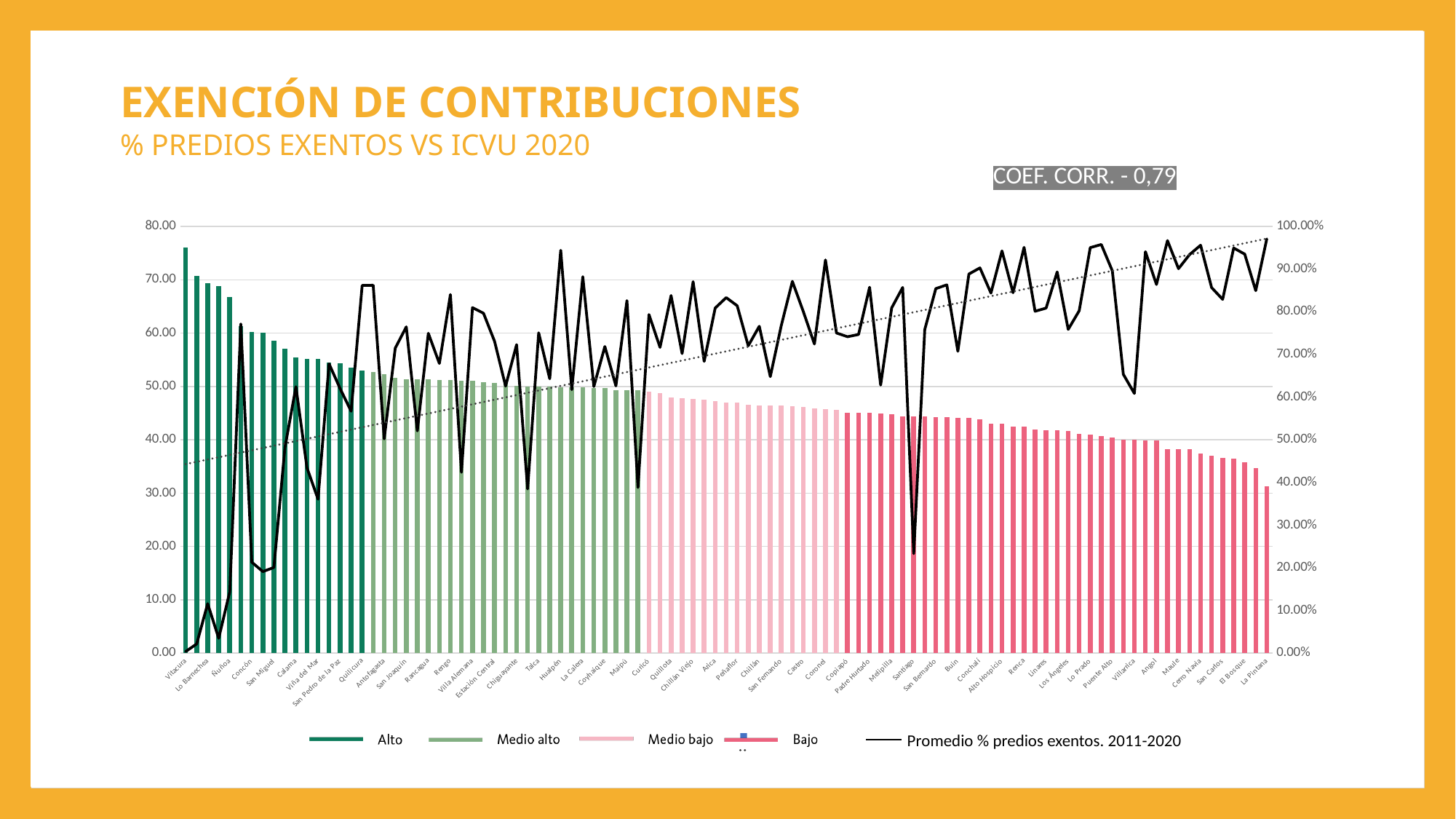
Which bar is taller, Vitacura or La Pintana? Vitacura How many entries does the legend list? 5 Which category has the tallest bar? Vitacura Do the bar values rise or fall from left to right along the x axis? fall Which category has the shortest bar? La Pintana Which legend entry is represented by the black line? Promedio % predios exentos. 2011-2020 What correlation coefficient is shown on the slide? -0,79 Is the bar value for Concón greater or less than 70? less What kind of chart is shown on the slide? A bar chart combined with a line chart Is the bar value for La Pintana greater or less than 40? less Is the line value (Promedio % predios exentos) for Santiago greater or less than 30.00%? less